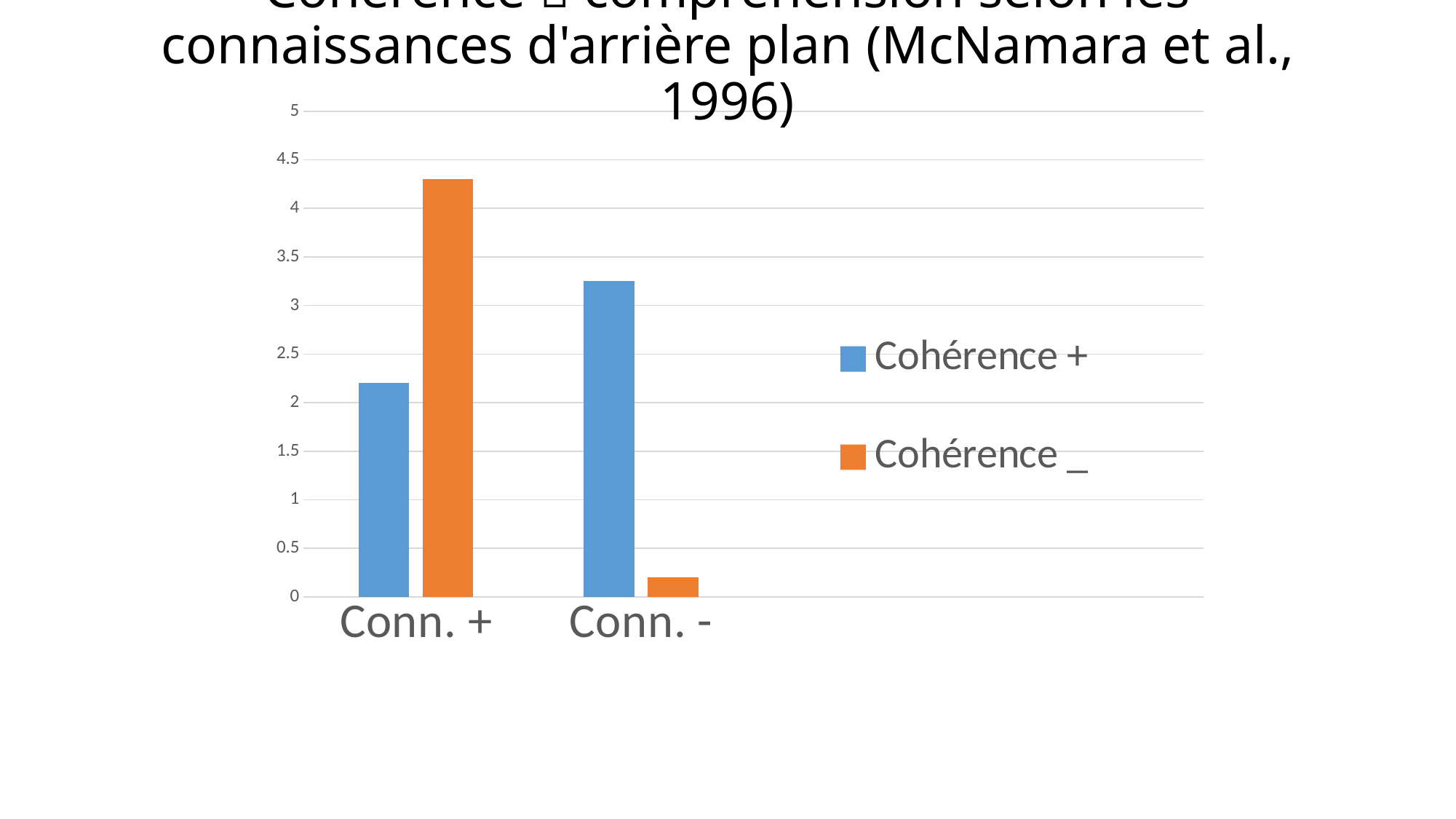
Which bar is the lowest in the chart? Cohérence _ at Conn. - Is the value for Cohérence _ at Conn. - greater or less than 0.5? less For Conn. +, which series has the larger value, Cohérence + or Cohérence _? Cohérence _ Which series is shown in blue? Cohérence + Is the value for Cohérence + at Conn. + greater or less than 2.5? less How many categories are shown on the x axis? 2 Is the value for Cohérence + at Conn. - greater or less than 3? greater For Conn. -, which series has the larger value, Cohérence + or Cohérence _? Cohérence + Which series is shown in orange? Cohérence _ What kind of chart is shown on the slide? bar chart How many series does the legend list? 2